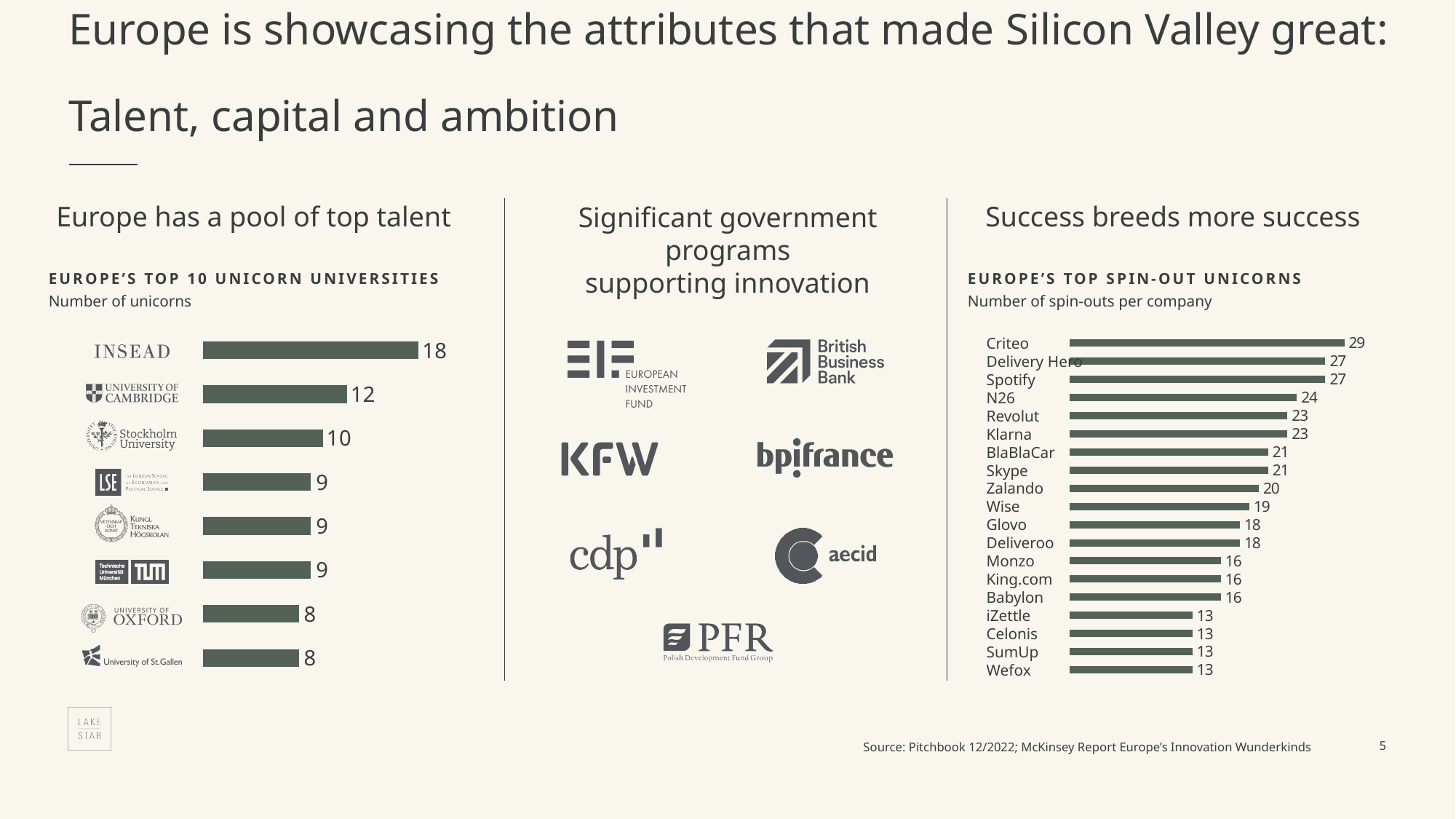
In the 'Europe's Top 10 Unicorn Universities' chart, which university has the highest number of unicorns? INSEAD In the 'Europe's Top 10 Unicorn Universities' chart, how many unicorns does INSEAD have? 18 In the 'Europe's Top Spin-Out Unicorns' chart, what does the subtitle say the values represent? Number of spin-outs per company In the 'Europe's Top Spin-Out Unicorns' chart, how many spin-outs does Zalando have? 20 In the 'Europe's Top Spin-Out Unicorns' chart, which has more spin-outs, N26 or Wise? N26 In the 'Europe's Top 10 Unicorn Universities' chart, what is the difference between INSEAD's and Stockholm University's number of unicorns? 8 In the 'Europe's Top 10 Unicorn Universities' chart, what kind of chart is used? Bar chart In the 'Europe's Top Spin-Out Unicorns' chart, what is the difference between Spotify's and Monzo's number of spin-outs? 11 In the 'Europe's Top Spin-Out Unicorns' chart, how many spin-outs does Criteo have? 29 In the 'Europe's Top Spin-Out Unicorns' chart, how many companies are listed? 19 In the 'Europe's Top 10 Unicorn Universities' chart, how many unicorns does the University of Cambridge have? 12 In the 'Europe's Top Spin-Out Unicorns' chart, which company has the highest number of spin-outs? Criteo